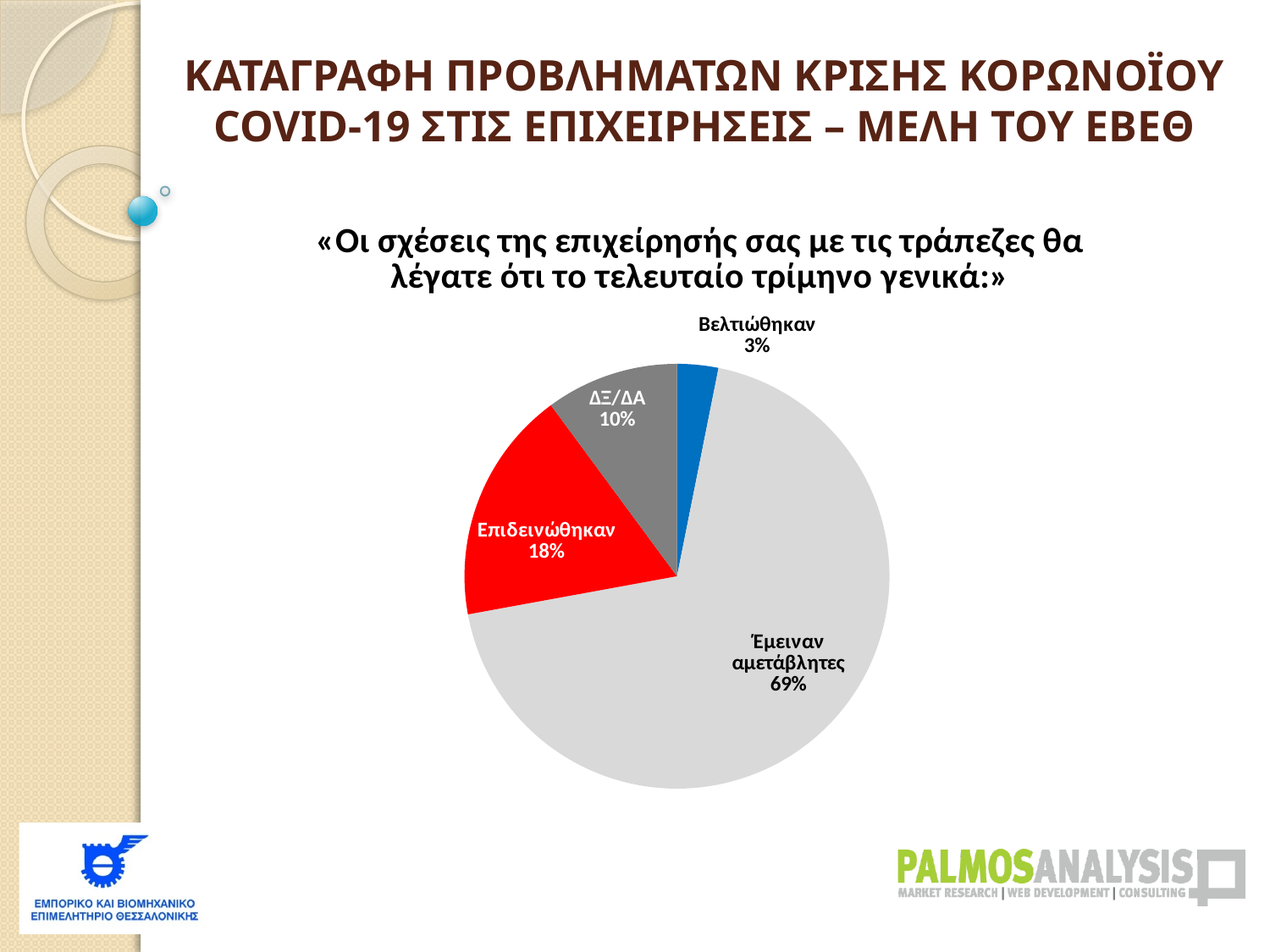
What type of chart is shown on the slide? pie chart Which category has the largest slice of the pie? Έμειναν αμετάβλητες What is the difference in percentage points between 'Έμειναν αμετάβλητες' and 'Επιδεινώθηκαν'? 51 What is the value shown for 'Βελτιώθηκαν'? 3% How many slices does the pie chart have? 4 What is the value shown for 'ΔΞ/ΔΑ'? 10% Which category has the smallest slice of the pie? Βελτιώθηκαν What share of the pie does the slice 'Έμειναν αμετάβλητες' represent? 69% What is the difference in percentage points between 'Επιδεινώθηκαν' and 'Βελτιώθηκαν'? 15 What colour is the slice for 'Επιδεινώθηκαν'? red What is the value shown for 'Επιδεινώθηκαν'? 18% Which is larger, the slice for 'Επιδεινώθηκαν' or the slice for 'ΔΞ/ΔΑ'? Επιδεινώθηκαν